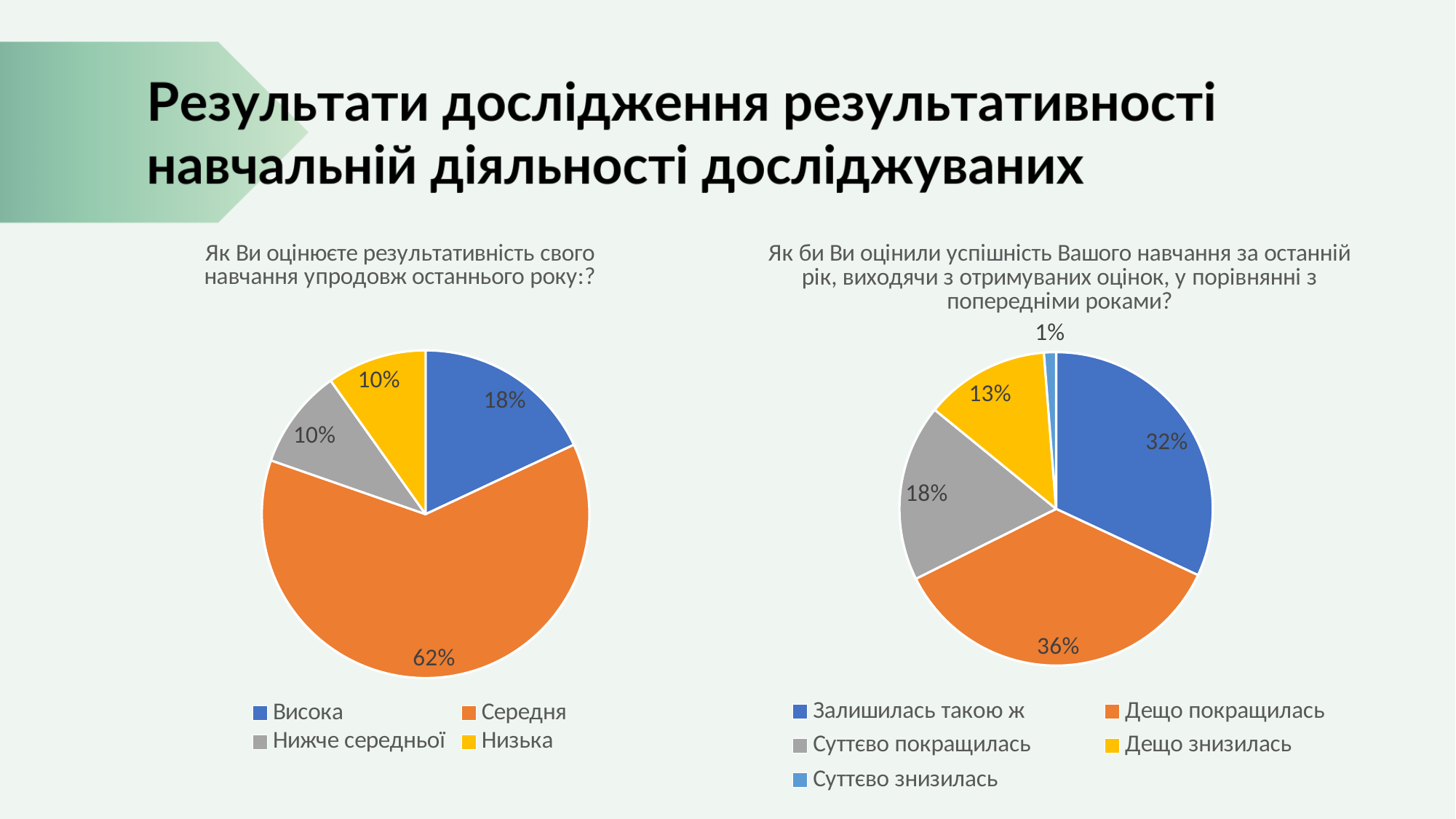
In the left pie chart, which category has the largest share? Середня In the right pie chart, what is the difference between 'Дещо покращилась' and 'Дещо знизилась'? 23% In the left pie chart, what share of respondents rated their learning effectiveness as 'Середня'? 62% In the right pie chart, which is larger: 'Залишилась такою ж' or 'Суттєво покращилась'? Залишилась такою ж How many categories does the legend of the right pie chart list? 5 What type of chart is used on the left side of the slide? Pie chart How many categories does the legend of the left pie chart list? 4 In the left pie chart, what is the value for 'Висока'? 18% In the right pie chart, what is the value for 'Суттєво знизилась'? 1% In the right pie chart, which category has the smallest share? Суттєво знизилась In the right pie chart, what is the value for 'Дещо покращилась'? 36% In the left pie chart, what is the difference between the 'Середня' and 'Висока' shares? 44%